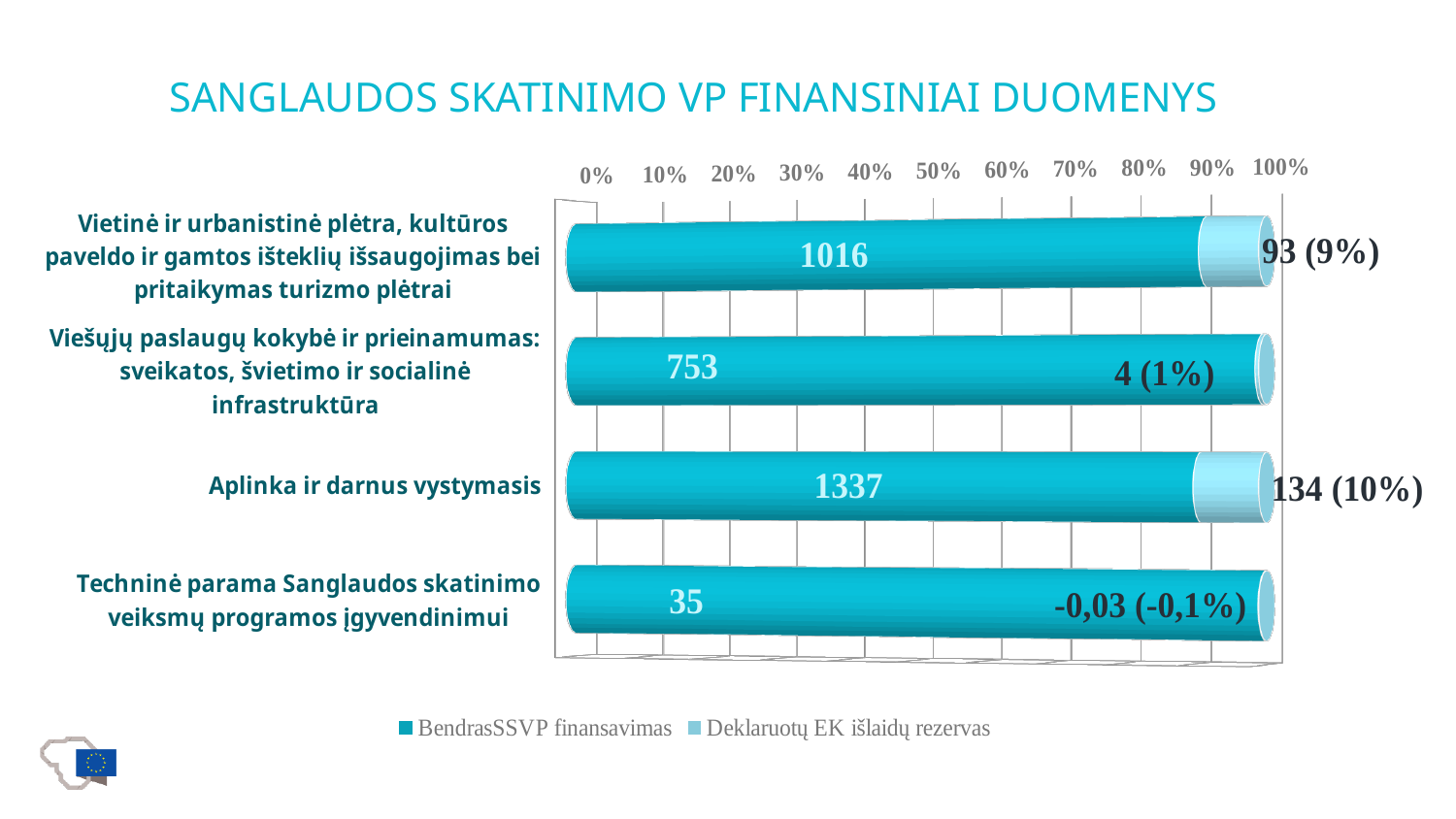
Which category has the highest BendrasSSVP finansavimas value? Aplinka ir darnus vystymasis What kind of chart is shown on the slide? bar chart What is the Deklaruotų EK išlaidų rezervas label for "Techninė parama Sanglaudos skatinimo veiksmų programos įgyvendinimui"? -0,03 (-0,1%) Which category has the lowest BendrasSSVP finansavimas value? Techninė parama Sanglaudos skatinimo veiksmų programos įgyvendinimui What is the BendrasSSVP finansavimas value for "Aplinka ir darnus vystymasis"? 1337 What is the title of the chart on the slide? SANGLAUDOS SKATINIMO VP FINANSINIAI DUOMENYS What is the BendrasSSVP finansavimas value for "Viešųjų paslaugų kokybė ir prieinamumas: sveikatos, švietimo ir socialinė infrastruktūra"? 753 How many series does the legend list? 2 What is the Deklaruotų EK išlaidų rezervas label for "Vietinė ir urbanistinė plėtra, kultūros paveldo ir gamtos išteklių išsaugojimas bei pritaikymas turizmo plėtrai"? 93 (9%) What is the difference between the BendrasSSVP finansavimas values for "Aplinka ir darnus vystymasis" and "Vietinė ir urbanistinė plėtra, kultūros paveldo ir gamtos išteklių išsaugojimas bei pritaikymas turizmo plėtrai"? 321 Which is larger: the Deklaruotų EK išlaidų rezervas value for "Aplinka ir darnus vystymasis" or for "Viešųjų paslaugų kokybė ir prieinamumas: sveikatos, švietimo ir socialinė infrastruktūra"? Aplinka ir darnus vystymasis How many categories are plotted in the chart? 4